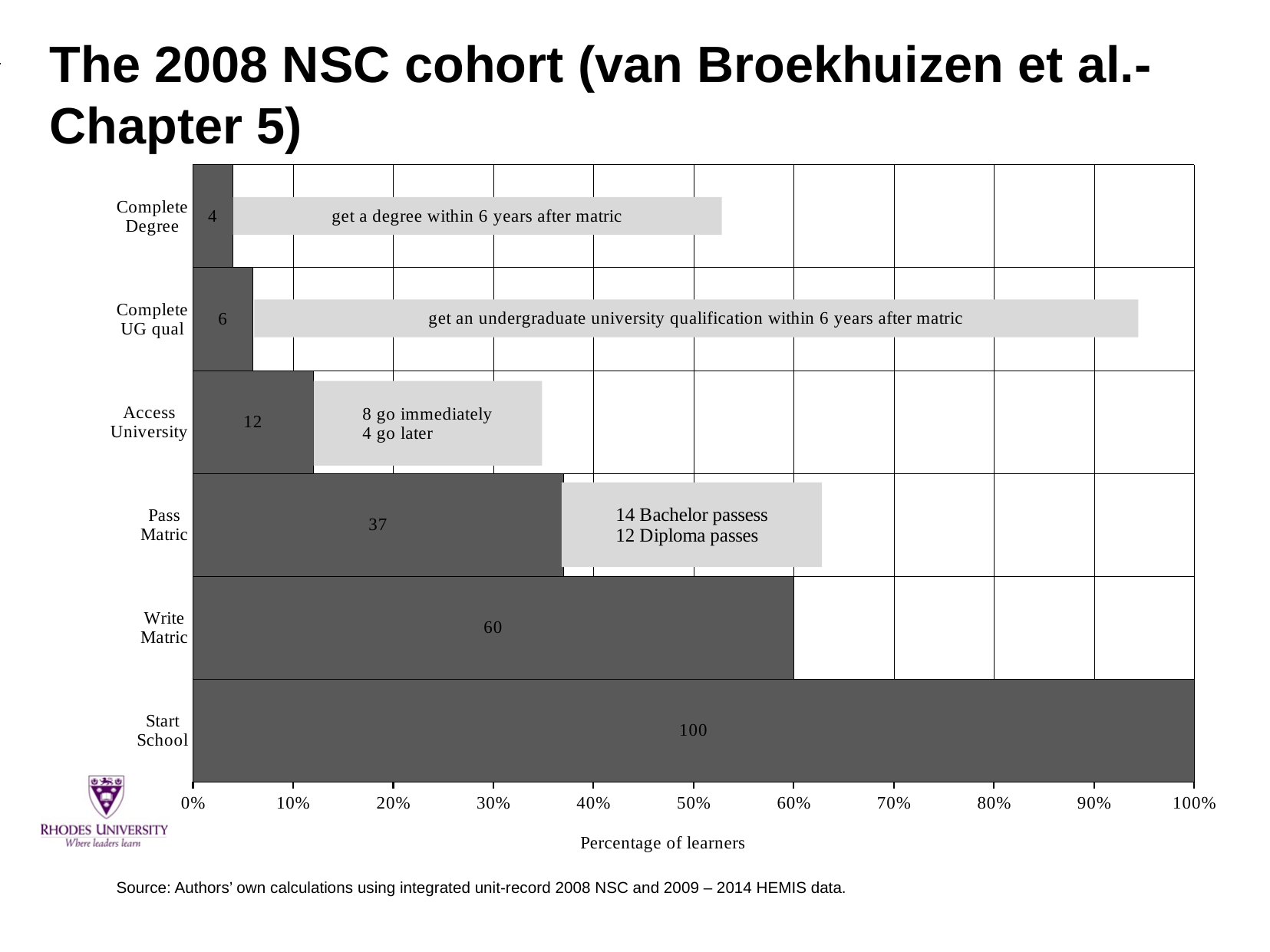
What is the difference between the values for Write Matric and Pass Matric? 23 What is the value for Access University? 12 Which category has the highest value? Start School Which category has the lowest value? Complete Degree What is the value for Write Matric? 60 Which is larger, the value for Complete UG qual or the value for Complete Degree? Complete UG qual What is the value for Complete Degree? 4 What is the label of the x axis? Percentage of learners According to the annotation, how many of the 37 who pass matric get Bachelor passes? 14 How many categories are shown on the chart? 6 What is the value for Pass Matric? 37 What kind of chart is this? bar chart